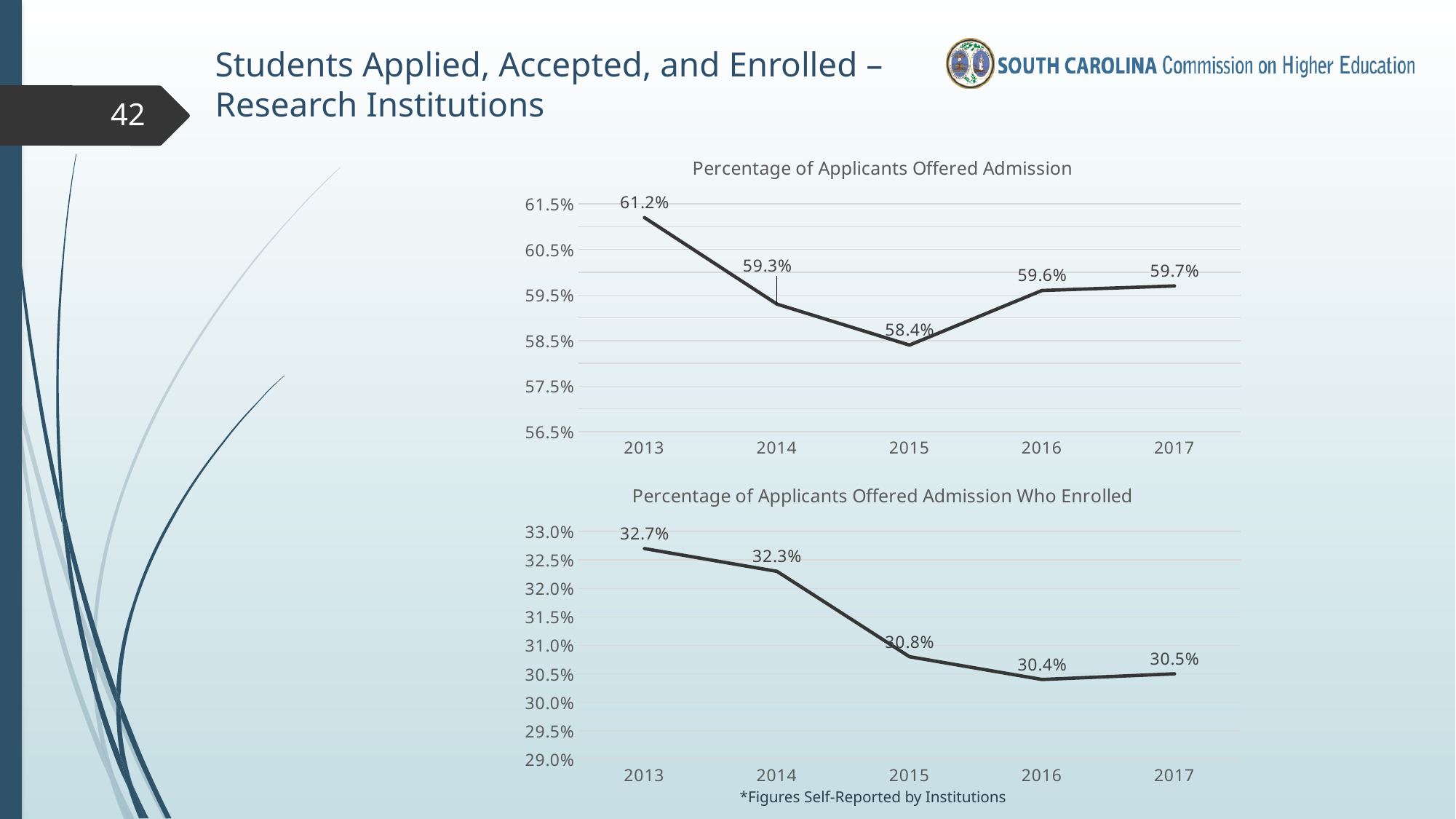
In the 'Percentage of Applicants Offered Admission Who Enrolled' chart, is the value for 2013 larger than the value for 2017? Yes In the 'Percentage of Applicants Offered Admission Who Enrolled' chart, do the values generally rise or fall from 2013 to 2016? fall In the 'Percentage of Applicants Offered Admission' chart, what is the value for 2013? 61.2% In the 'Percentage of Applicants Offered Admission' chart, which year has the highest value? 2013 In the 'Percentage of Applicants Offered Admission Who Enrolled' chart, is the value for 2015 greater or less than 31.0%? less In the 'Percentage of Applicants Offered Admission' chart, how many years are plotted? 5 What kind of chart is the 'Percentage of Applicants Offered Admission' chart? line chart In the 'Percentage of Applicants Offered Admission Who Enrolled' chart, which year has the highest value? 2013 In the 'Percentage of Applicants Offered Admission Who Enrolled' chart, what is the value for 2016? 30.4% In the 'Percentage of Applicants Offered Admission Who Enrolled' chart, what is the value for 2014? 32.3% In the 'Percentage of Applicants Offered Admission' chart, which year has the lowest value? 2015 In the 'Percentage of Applicants Offered Admission' chart, what is the difference between the 2013 and 2015 values? 2.8%